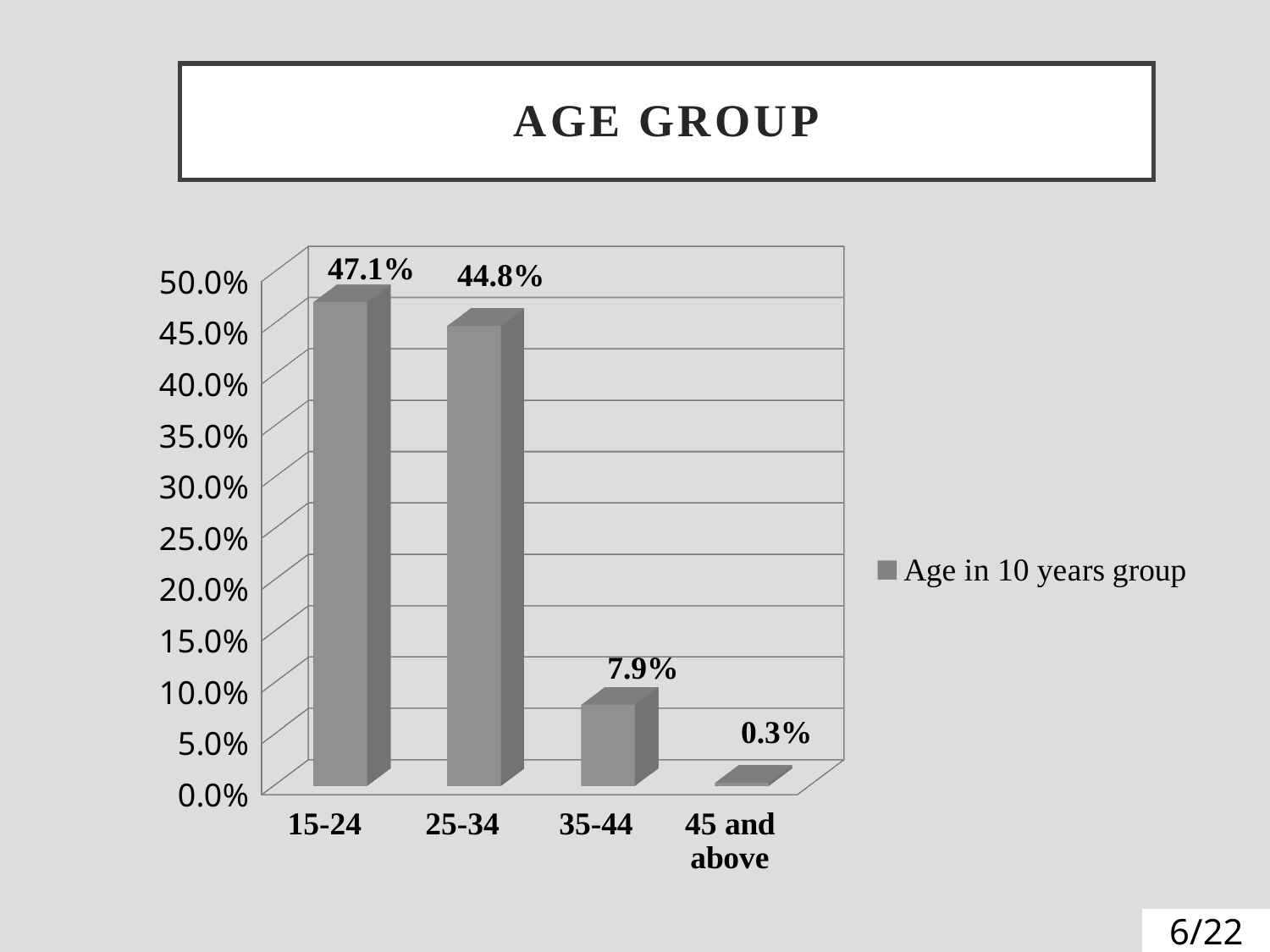
What is the value for the 15-24 age group? 47.1% What is the difference between the values for 15-24 and 25-34? 2.3% What is the value for the 35-44 age group? 7.9% How many age group categories are shown on the x axis? 4 What series name does the legend list? Age in 10 years group Which age group has the lowest value? 45 and above What kind of chart is shown on the slide? Bar chart What is the value for the 25-34 age group? 44.8% Which age group has the highest value? 15-24 Which is larger, the value for 25-34 or the value for 35-44? 25-34 What is the value for the 45 and above age group? 0.3% What is the difference between the values for 35-44 and 45 and above? 7.6%